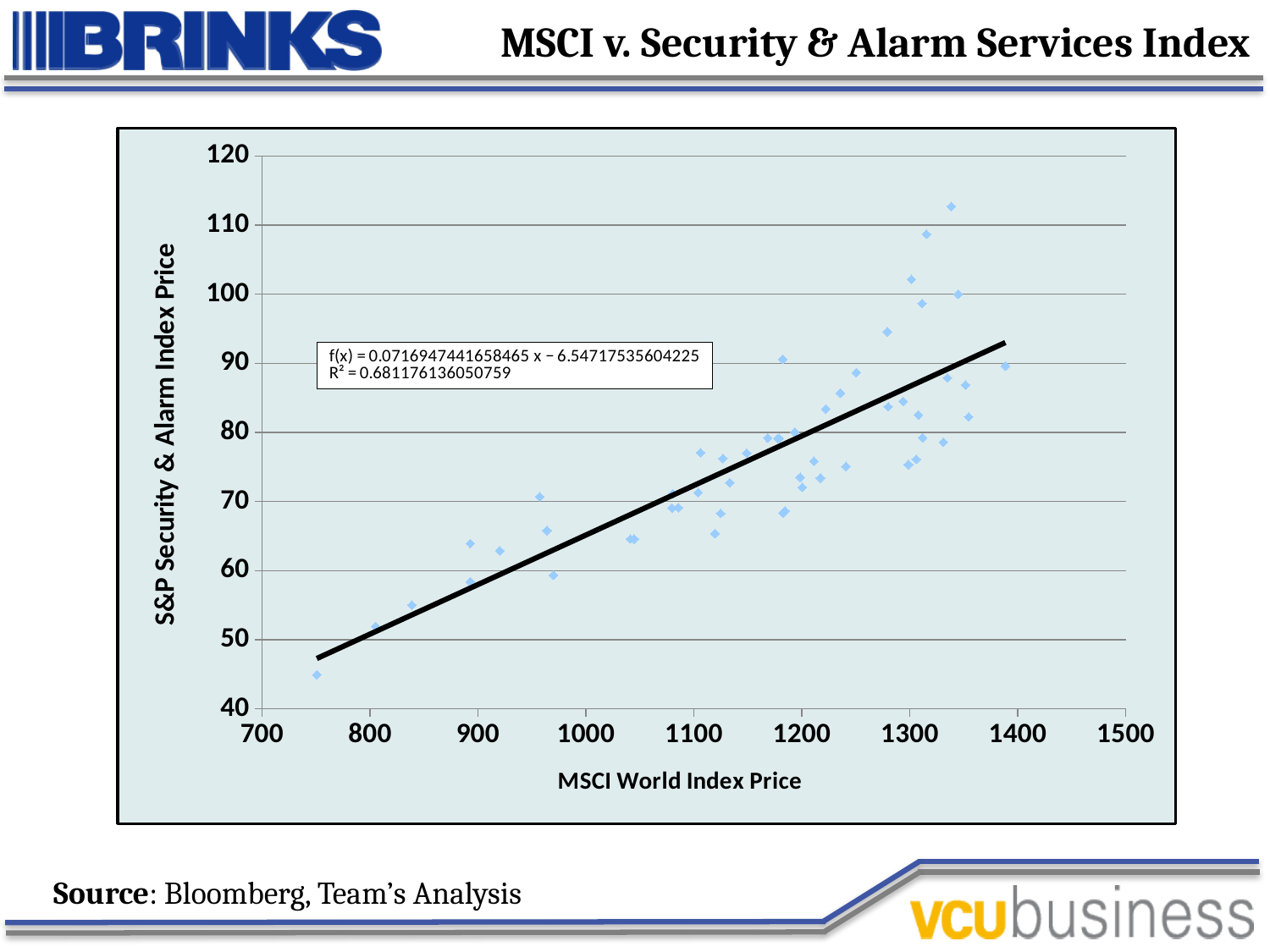
As the MSCI World Index Price increases along the x axis, do the S&P Security & Alarm Index Price values generally rise or fall? Rise What is the label on the x axis of the chart? MSCI World Index Price What kind of chart is shown on the slide? Scatter chart Is the lowest plotted point's S&P Security & Alarm Index Price greater or less than 50? less What is the title of the chart on the slide? MSCI v. Security & Alarm Services Index What is the slope coefficient in the trendline equation printed on the chart? 0.0716947441658465 What is the intercept in the trendline equation printed on the chart? −6.54717535604225 Is the MSCI World Index Price of the leftmost plotted point greater or less than 800? less What R² value is printed on the chart? 0.681176136050759 Does the fitted trendline on the chart slope upward or downward from left to right? Upward Is the highest plotted point's S&P Security & Alarm Index Price greater or less than 110? greater